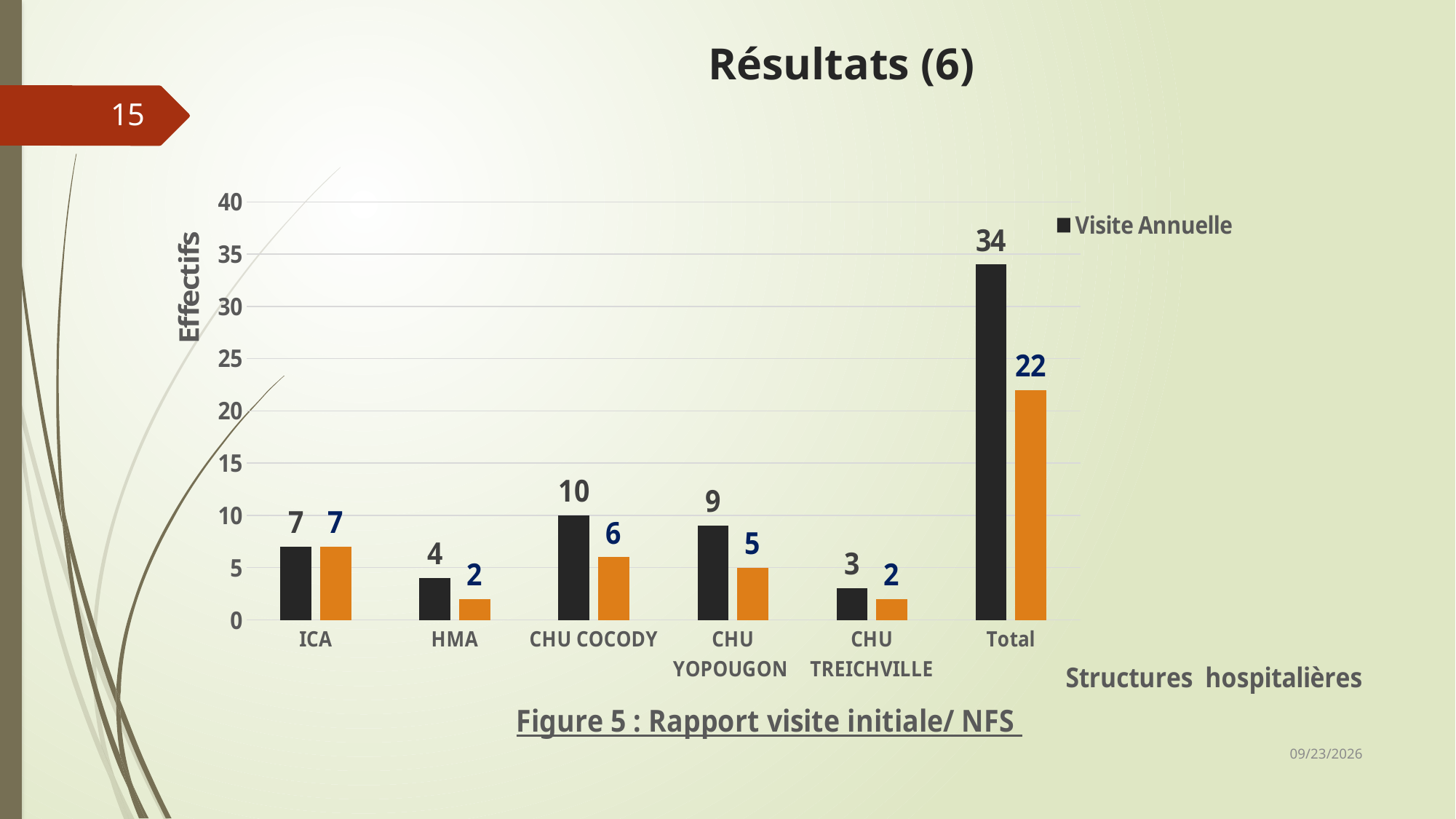
What is the value of the orange bar for CHU YOPOUGON? 5 Excluding Total, which hospital structure has the lowest Visite Annuelle value? CHU TREICHVILLE What is the Visite Annuelle value for CHU COCODY? 10 What is the title of the vertical axis of the chart? Effectifs Excluding Total, which hospital structure has the highest Visite Annuelle value? CHU COCODY What is the Visite Annuelle value for the Total category? 34 What is the value of the orange bar for HMA? 2 What kind of chart is shown on the slide? bar chart Is the Visite Annuelle value for Total greater or less than 30? greater For HMA, which is larger: the Visite Annuelle bar or the orange bar? Visite Annuelle How many categories are shown on the x axis of the chart? 6 For the Total category, what is the difference between the Visite Annuelle bar and the orange bar? 12